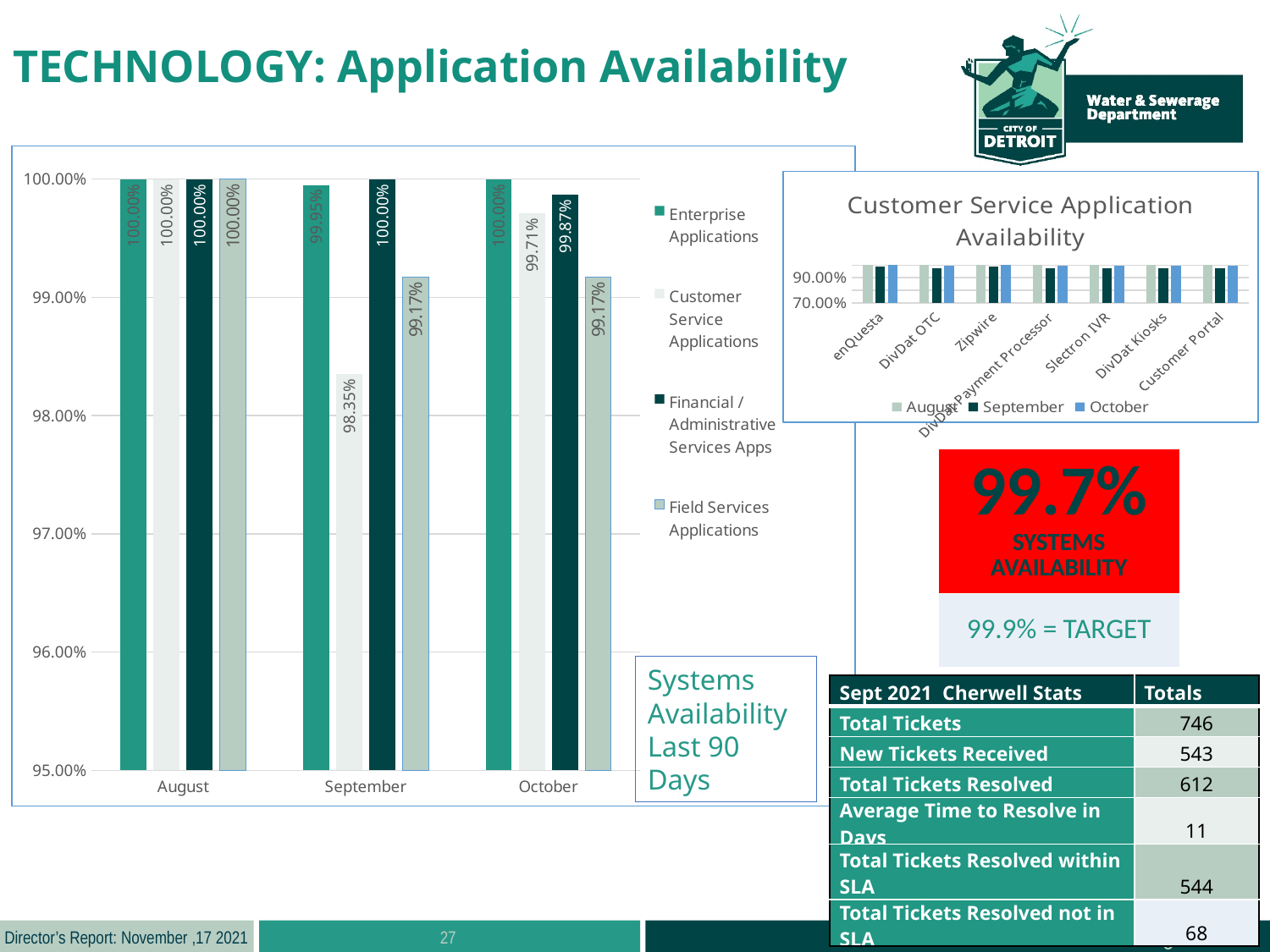
How many series does the legend of the Systems Availability Last 90 Days chart list? 4 In the Systems Availability Last 90 Days chart, what is the value for Customer Service Applications in September? 98.35% In the Systems Availability Last 90 Days chart, what is the value for Enterprise Applications in September? 99.95% What kind of chart is the Systems Availability Last 90 Days chart? Bar chart How many months are shown on the x axis of the Systems Availability Last 90 Days chart? 3 In the Systems Availability Last 90 Days chart, which series has the lowest value in September? Customer Service Applications How many applications are listed on the x axis of the Customer Service Application Availability chart? 7 In the Systems Availability Last 90 Days chart, which is larger in October: Customer Service Applications or Financial / Administrative Services Apps? Financial / Administrative Services Apps In the Systems Availability Last 90 Days chart, what is the difference between the Customer Service Applications values for October and September? 1.36% In the Customer Service Application Availability chart, is the value for Zipwire in October greater or less than 90.00%? greater In the Systems Availability Last 90 Days chart, what is the value for Field Services Applications in October? 99.17% In the Systems Availability Last 90 Days chart, what is the value for Financial / Administrative Services Apps in October? 99.87%